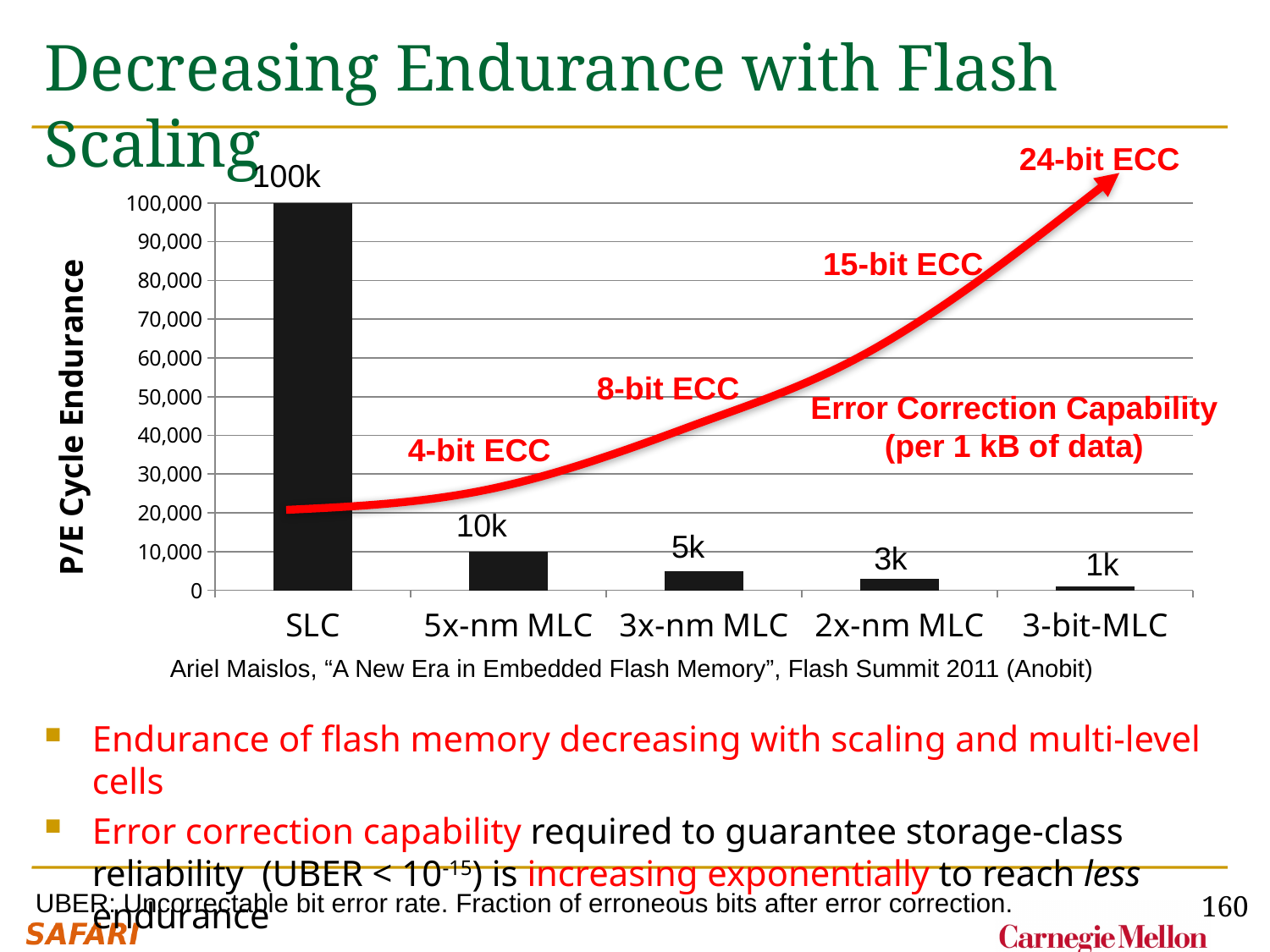
What is the P/E cycle endurance value shown for 5x-nm MLC? 10k Is the value for 5x-nm MLC greater or less than 20,000? less What is the P/E cycle endurance value shown for 3-bit-MLC? 1k What is the P/E cycle endurance value shown for SLC? 100k Do the P/E cycle endurance values rise or fall from left to right along the x axis? fall Which has a higher P/E cycle endurance, 3x-nm MLC or 2x-nm MLC? 3x-nm MLC How many categories are shown on the x axis of the chart? 5 What is the P/E cycle endurance value shown for 2x-nm MLC? 3k Which category has the highest P/E cycle endurance? SLC Which category has the lowest P/E cycle endurance? 3-bit-MLC What kind of chart is used to show P/E cycle endurance? bar chart What is the label of the y axis of the chart? P/E Cycle Endurance